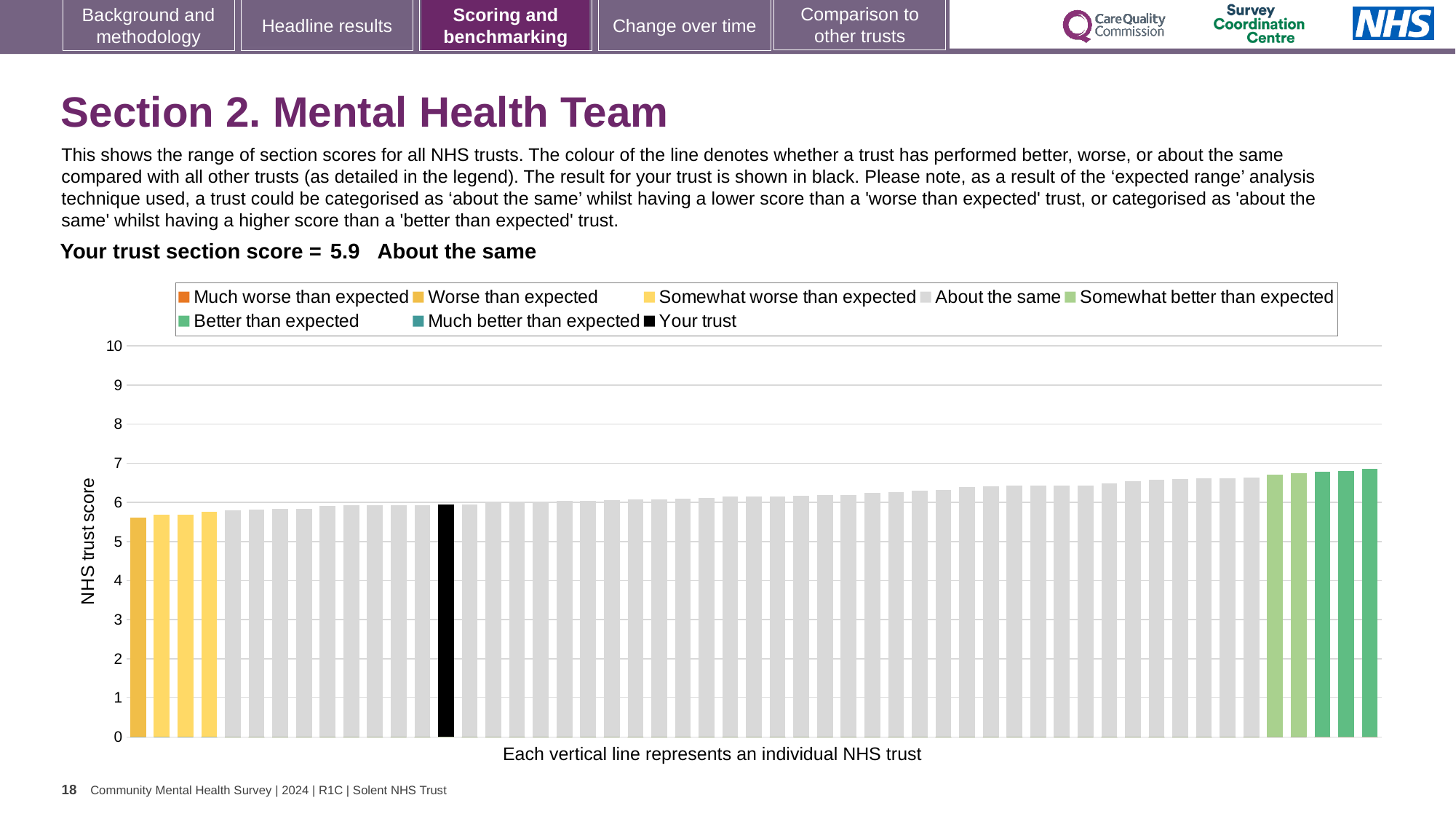
Is the value of the shortest bar greater or less than 5? greater Do the bar values rise or fall from left to right across the chart? rise Which legend category does the shortest bar on the left of the chart belong to? Worse than expected Is the value of the black 'Your trust' bar greater or less than 5? greater Which category is your trust placed in for this section? About the same What kind of chart is shown on the slide? bar chart What colour is the bar representing your trust? black What is the label on the vertical axis of the chart? NHS trust score Is the value of the tallest bar greater or less than 7? less Which legend category do the tallest bars on the right of the chart belong to? Better than expected What is the section score for your trust shown on the slide? 5.9 How many entries does the chart legend list? 8